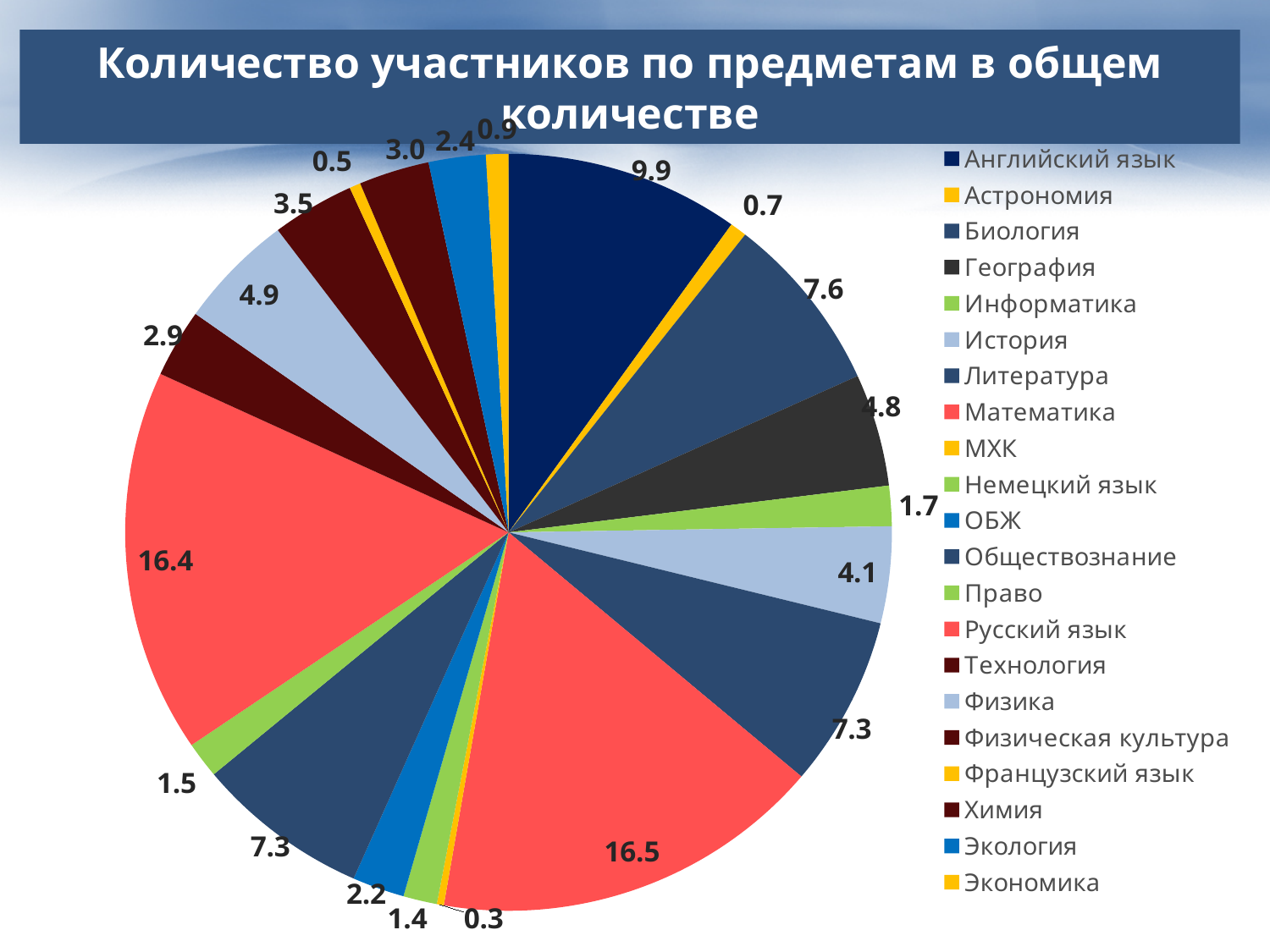
What is the value for Математика? 16.5 What is the difference between the values for Английский язык and География? 5.1 Which is larger, the value for Биология or the value for Литература? Биология What is the value for Английский язык? 9.9 What is the value for Русский язык? 16.4 Which is larger, the value for История or the value for Физика? Физика What is the value for Физика? 4.9 How many categories (subjects) does the pie chart show? 21 What is the value for Биология? 7.6 What is the title of the chart? Количество участников по предметам в общем количестве What type of chart is shown on the slide? pie chart What is the value for МХК? 0.3